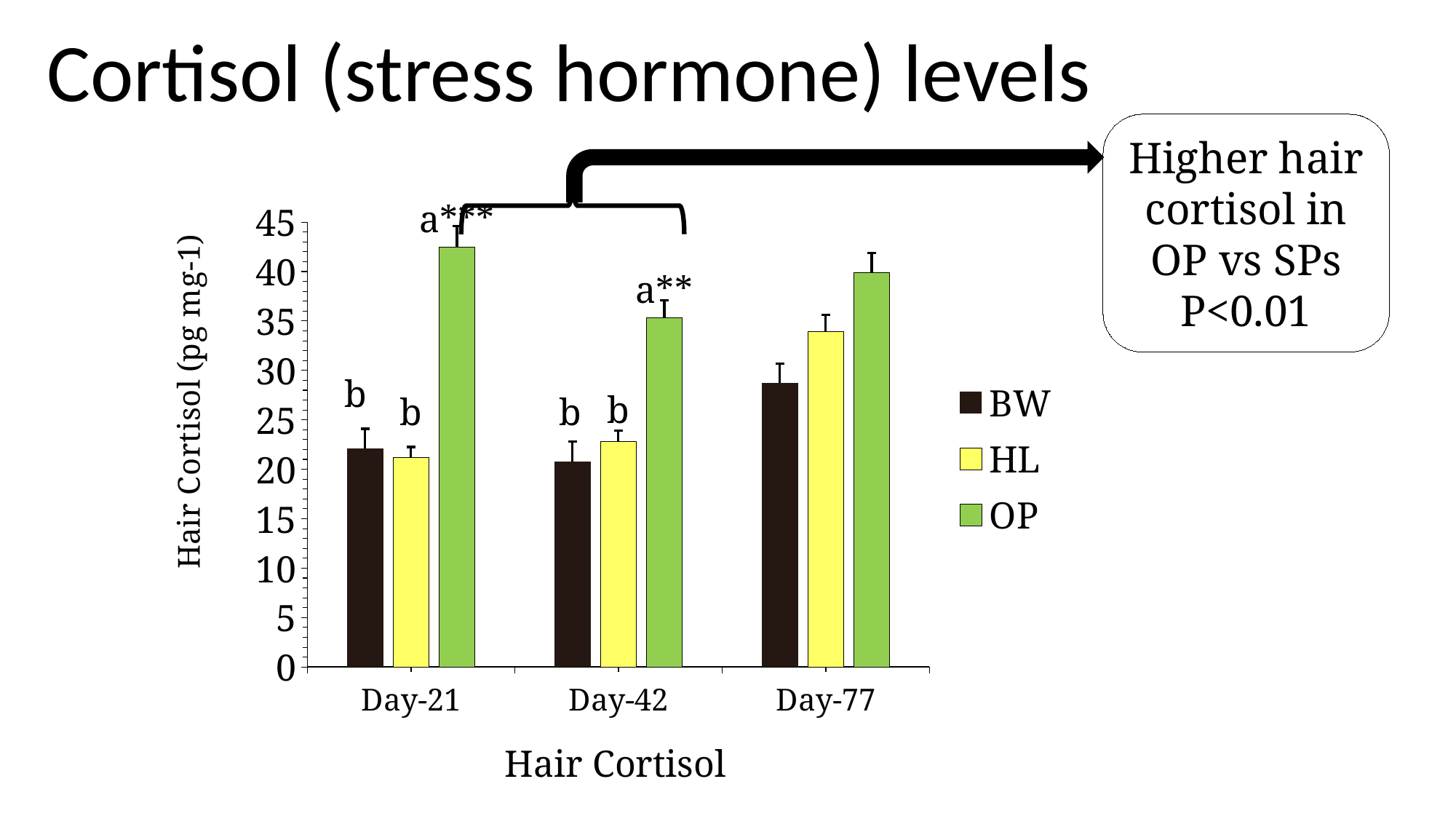
What kind of chart is shown on the slide? bar chart Do the HL values rise or fall from Day-21 to Day-77? rise Is the value for HL at Day-77 greater or less than 30? greater At Day-77, which is larger, HL or BW? HL Is the value for OP at Day-21 greater or less than 40? greater Is the value for BW at Day-42 greater or less than 25? less Which is larger, OP at Day-21 or OP at Day-42? OP at Day-21 Which series has the lowest hair cortisol at Day-77? BW How many day categories are shown on the x axis? 3 Which series has the highest hair cortisol at Day-21? OP What is the label on the y axis? Hair Cortisol (pg mg-1) How many series does the legend list? 3